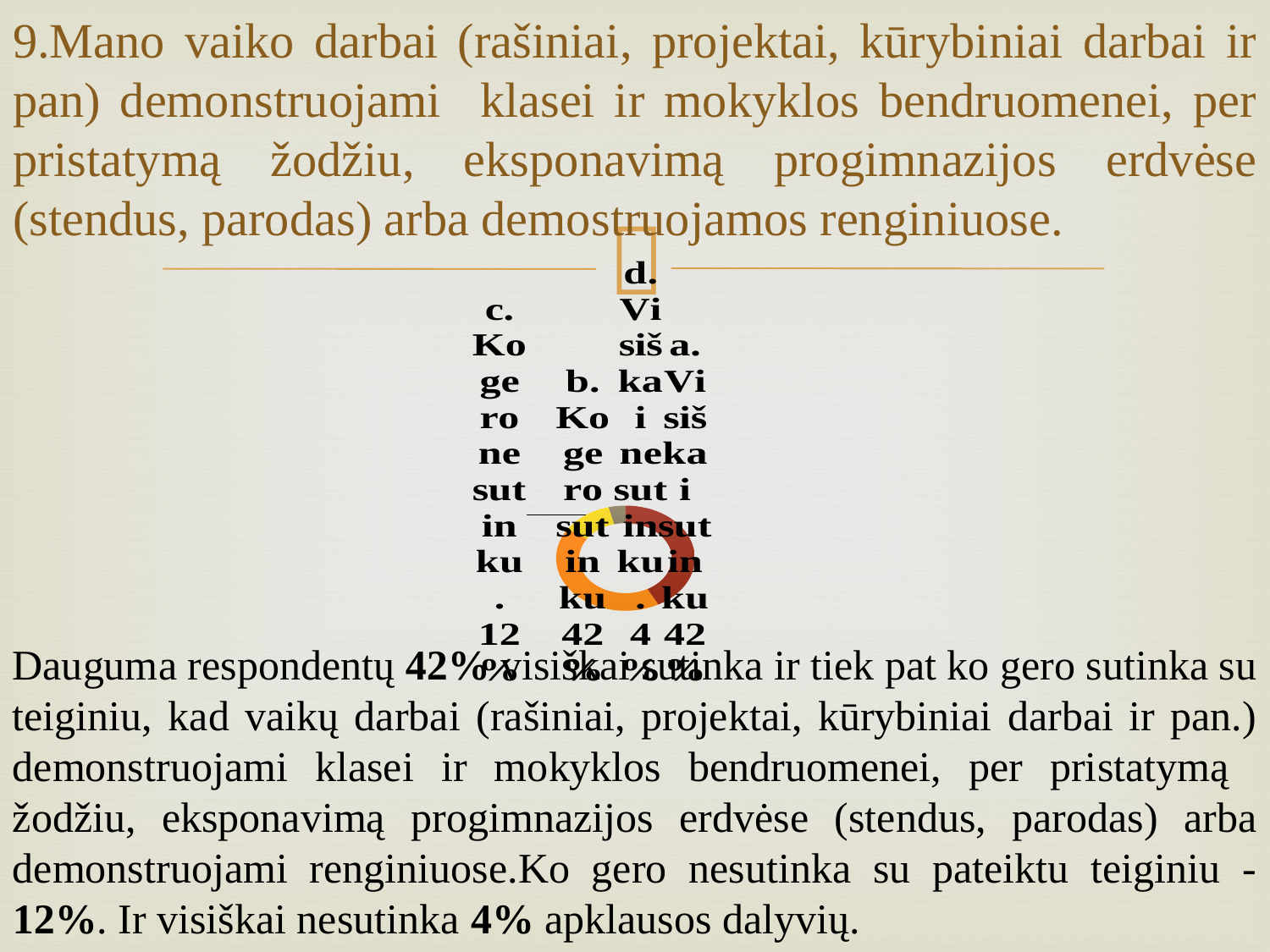
What kind of chart is shown on the slide? Doughnut (pie) chart Which is larger, "a. Visiškai sutinku" or "c. Ko gero nesutinku"? a. Visiškai sutinku Which is larger, "c. Ko gero nesutinku" or "d. Visiškai nesutinku"? c. Ko gero nesutinku What is the value for "a. Visiškai sutinku"? 42% What is the value for "b. Ko gero sutinku"? 42% What is the value for "d. Visiškai nesutinku"? 4% What share of the pie does "d. Visiškai nesutinku" take? 4% How many categories does the chart show? 4 What is the difference between "c. Ko gero nesutinku" and "d. Visiškai nesutinku"? 8 percentage points What is the value for "c. Ko gero nesutinku"? 12% What is the difference between "b. Ko gero sutinku" and "c. Ko gero nesutinku"? 30 percentage points Which category has the smallest slice? d. Visiškai nesutinku